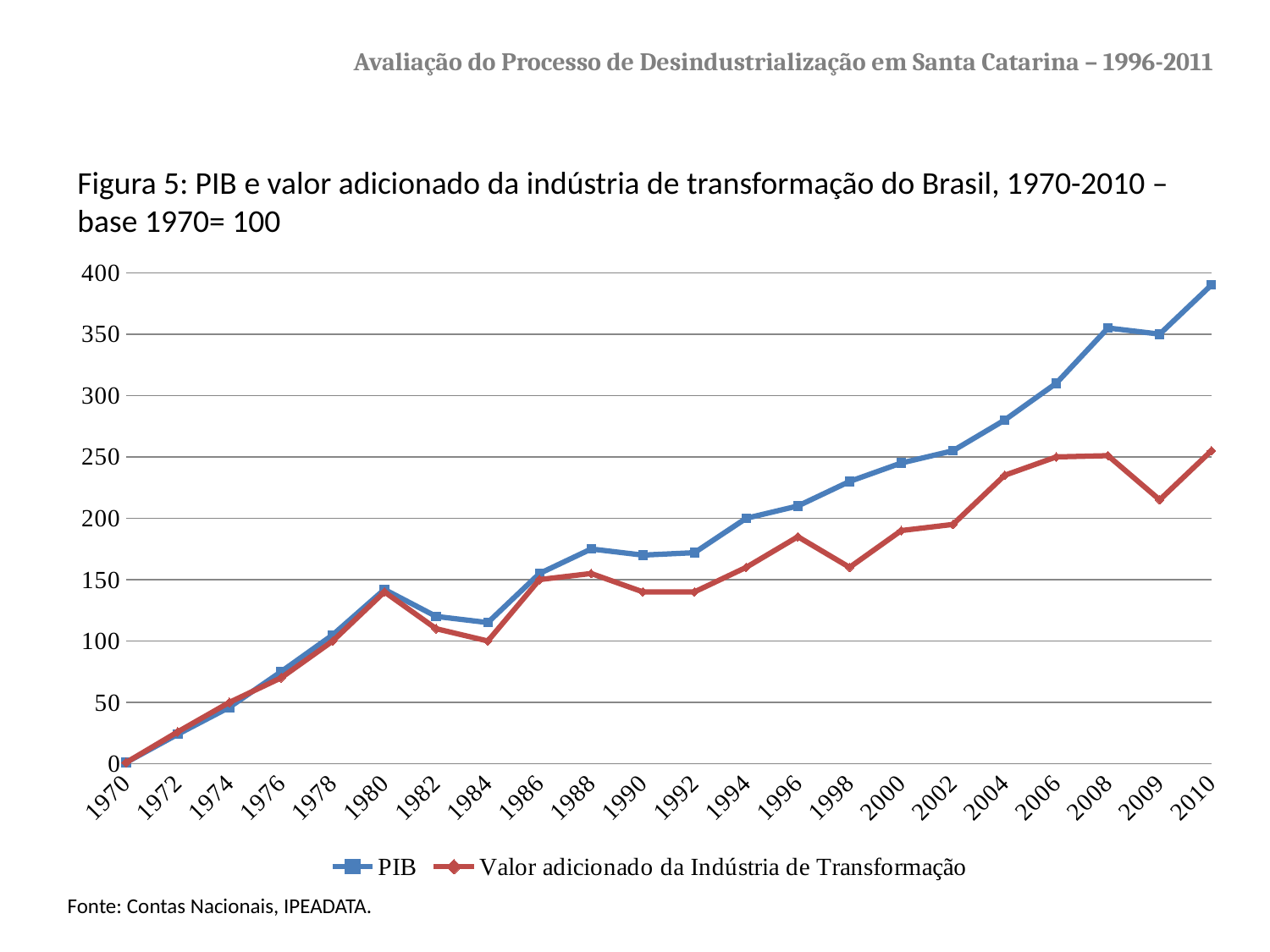
What kind of chart is shown on the slide? line chart What are the two series named in the legend? PIB; Valor adicionado da Indústria de Transformação In which year does the PIB series reach its highest value? 2010 Is the PIB value for 2000 greater or less than 200? greater Does the Valor adicionado da Indústria de Transformação series rise or fall from 1996 to 1998? fall Is the PIB value for 2010 greater or less than 350? greater In 2010, which series has the larger value, PIB or Valor adicionado da Indústria de Transformação? PIB Is the value of Valor adicionado da Indústria de Transformação for 2009 greater or less than 250? less How many series does the legend list? 2 How many years are shown along the x axis? 22 Does the PIB series rise or fall from 2008 to 2009? fall In which year is the PIB series at its lowest value? 1970